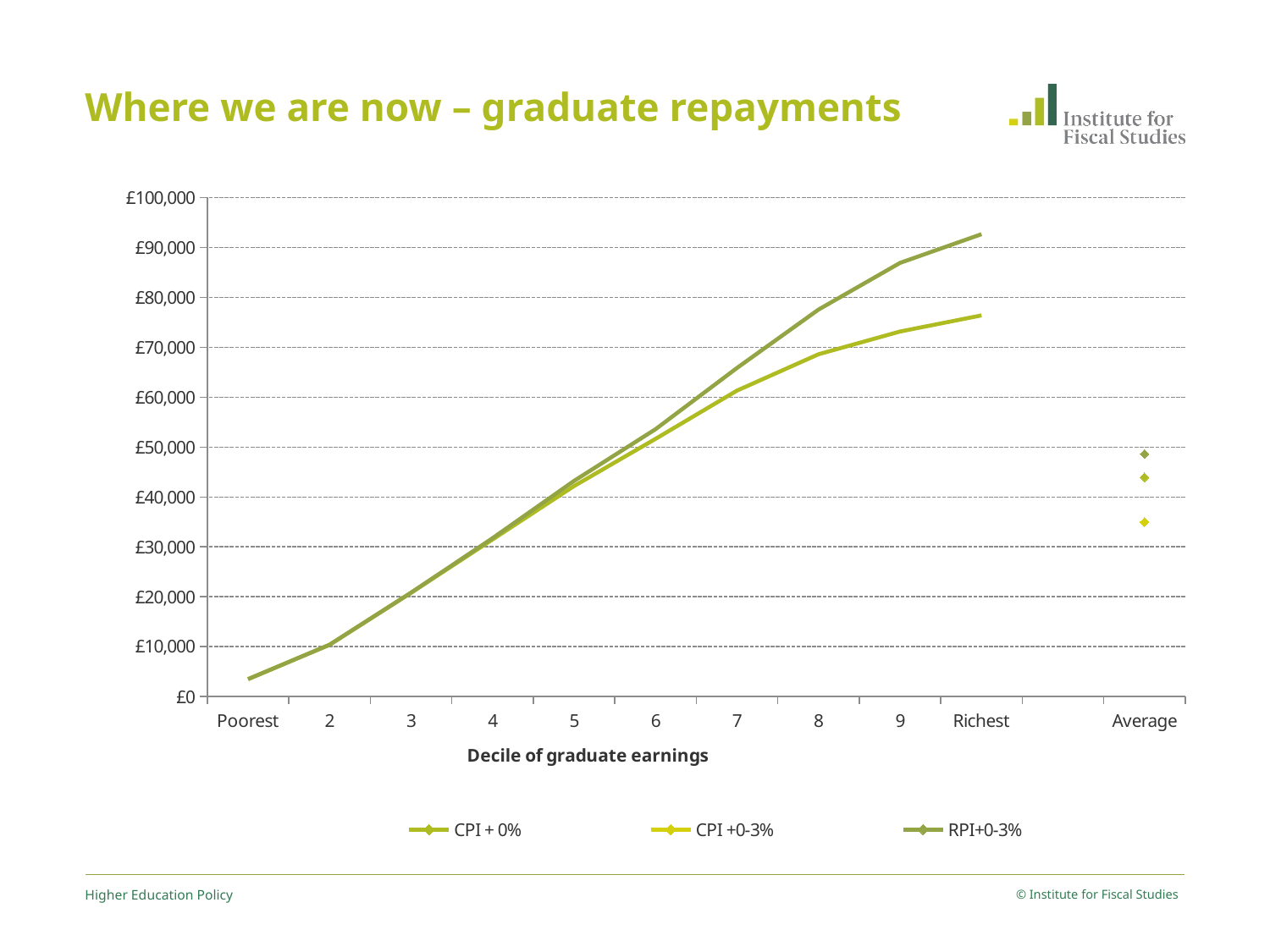
Is the Average value for CPI +0-3% greater or less than £40,000? less Is the value for RPI+0-3% at decile 9 greater or less than £80,000? greater Is the value for RPI+0-3% at the Richest decile greater or less than £90,000? greater How many decile categories (from Poorest to Richest) are shown on the x axis? 10 How many series does the legend list? 3 Do graduate repayments rise or fall from the Poorest decile to the Richest decile? rise What is the label on the x axis of the chart? Decile of graduate earnings What is the title of the chart on the slide? Where we are now – graduate repayments What kind of chart is shown on the slide? line chart